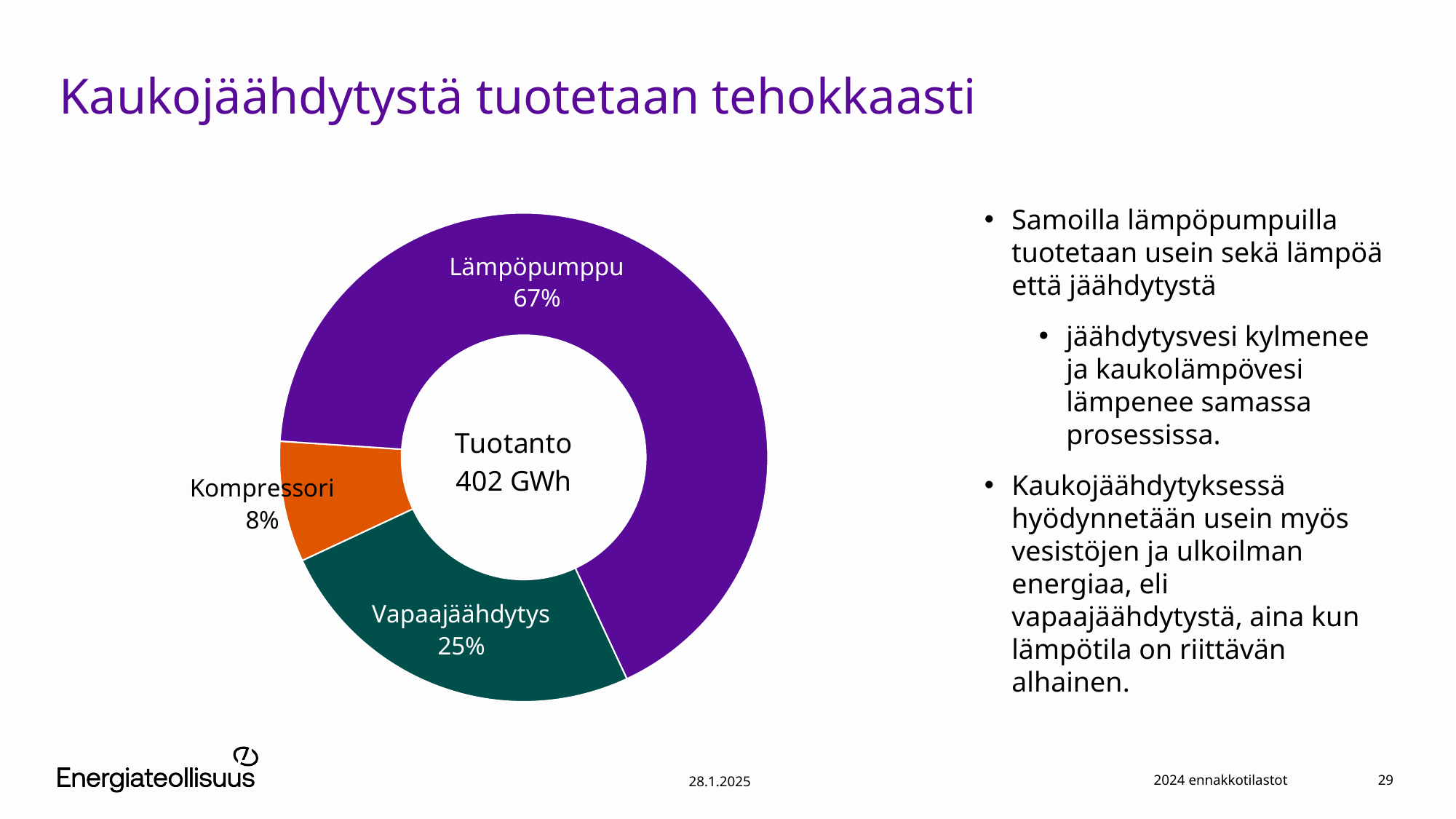
Which has a larger share, Vapaajäähdytys or Kompressori? Vapaajäähdytys What share of the chart does Lämpöpumppu account for? 67% What share of the chart does Vapaajäähdytys account for? 25% Which category has the smallest share in the chart? Kompressori How many categories are shown in the chart? 3 What total production value is shown in the centre of the chart? 402 GWh What kind of chart is shown on the slide? Doughnut (pie) chart What colour is the Kompressori segment of the chart? Orange What is the difference in percentage points between the Lämpöpumppu and Vapaajäähdytys shares? 42 What is the difference in percentage points between the Vapaajäähdytys and Kompressori shares? 17 Which category has the largest share in the chart? Lämpöpumppu What share of the chart does Kompressori account for? 8%